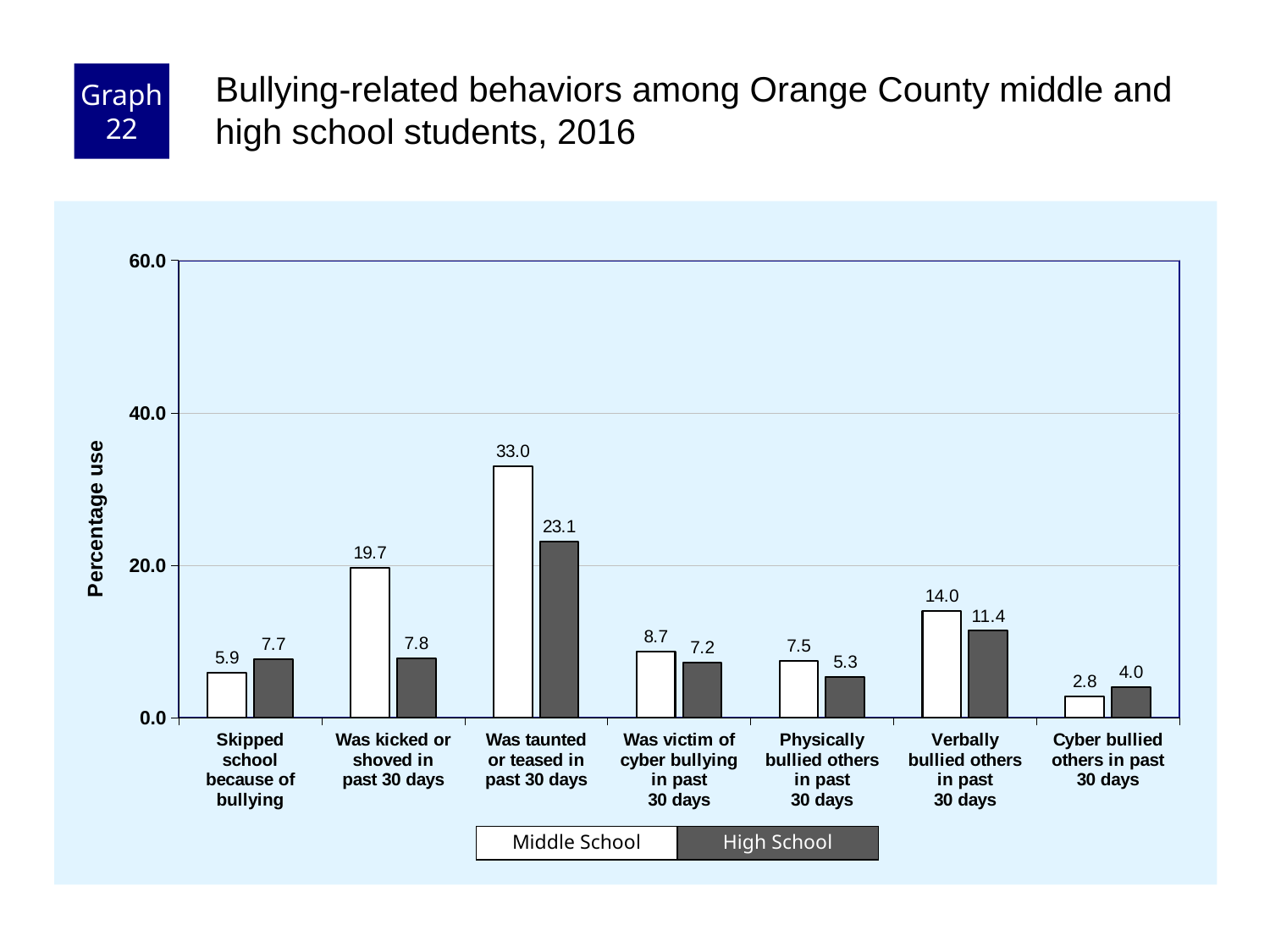
Which is larger for "Skipped school because of bullying": the Middle School value or the High School value? High School What is the High School value for "Verbally bullied others in past 30 days"? 11.4 How many series does the legend list? 2 Which category has the highest High School value? Was taunted or teased in past 30 days What is the Middle School value for "Was taunted or teased in past 30 days"? 33.0 Is the Middle School value for "Was taunted or teased in past 30 days" greater or less than 40.0? less What is the Middle School value for "Cyber bullied others in past 30 days"? 2.8 Which category has the lowest Middle School value? Cyber bullied others in past 30 days What is the label of the y axis? Percentage use What kind of chart is shown on the slide? Bar chart What is the difference between the Middle School and High School values for "Was kicked or shoved in past 30 days"? 11.9 How many categories are shown on the x axis? 7